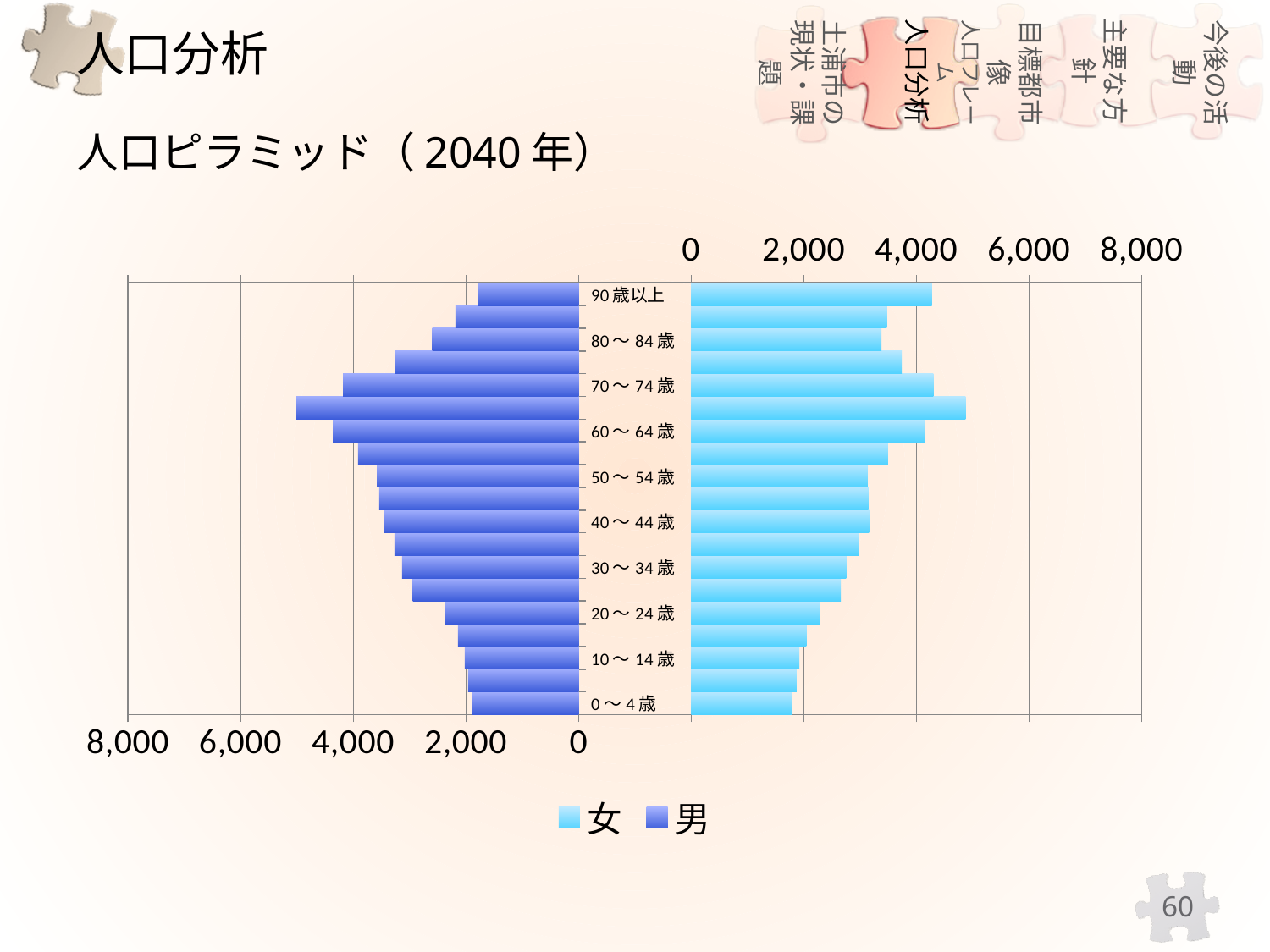
What kind of chart is shown on the slide? bar chart Is the value for 女 in the 80～84歳 group greater or less than 2,000? greater Is the value for 男 in the 90歳以上 group greater or less than 2,000? less What are the two series named in the legend? 女 and 男 Is the value for 男 in the 0～4歳 group greater or less than 2,000? less How many age-group labels are printed on the central axis of the chart? 10 What is the title of the chart? 人口ピラミッド（2040年） For the 80～84歳 group, which is larger, 女 or 男? 女 How many series does the legend list? 2 For the 90歳以上 group, which is larger, 女 or 男? 女